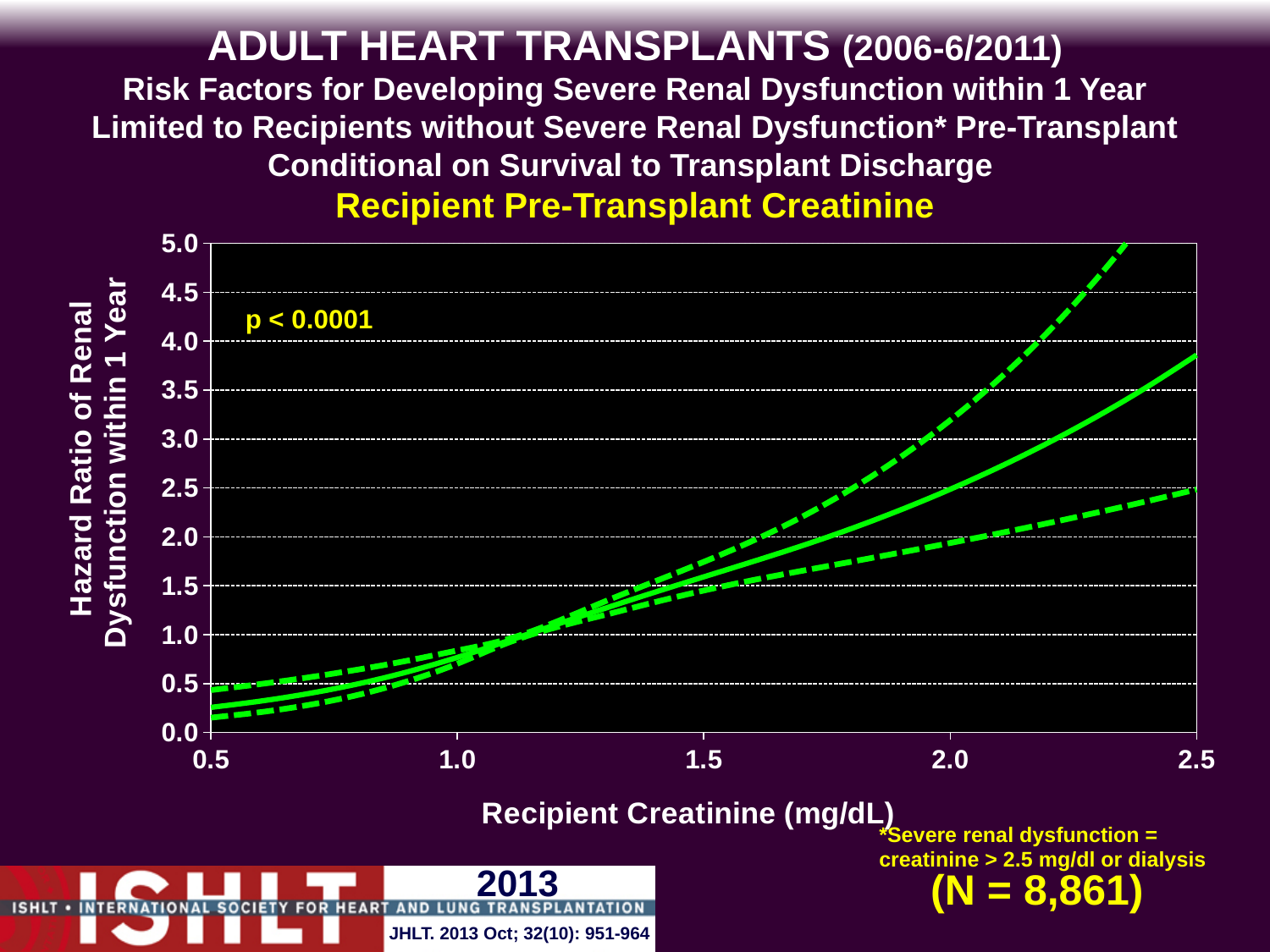
Is the hazard ratio shown by the solid line at a recipient creatinine of 0.5 mg/dL greater or less than 0.5? less How many tick labels are shown on the x axis? 5 What kind of chart is shown on the slide? line chart Is the lower dashed line at a recipient creatinine of 2.5 mg/dL greater or less than 3.0? less Does the hazard ratio rise or fall as recipient creatinine increases from 0.5 to 2.5 mg/dL? rise Is the hazard ratio shown by the solid line at a recipient creatinine of 2.5 mg/dL greater or less than 3.0? greater What p-value is printed on the chart? p < 0.0001 What is the highest value labelled on the y axis? 5.0